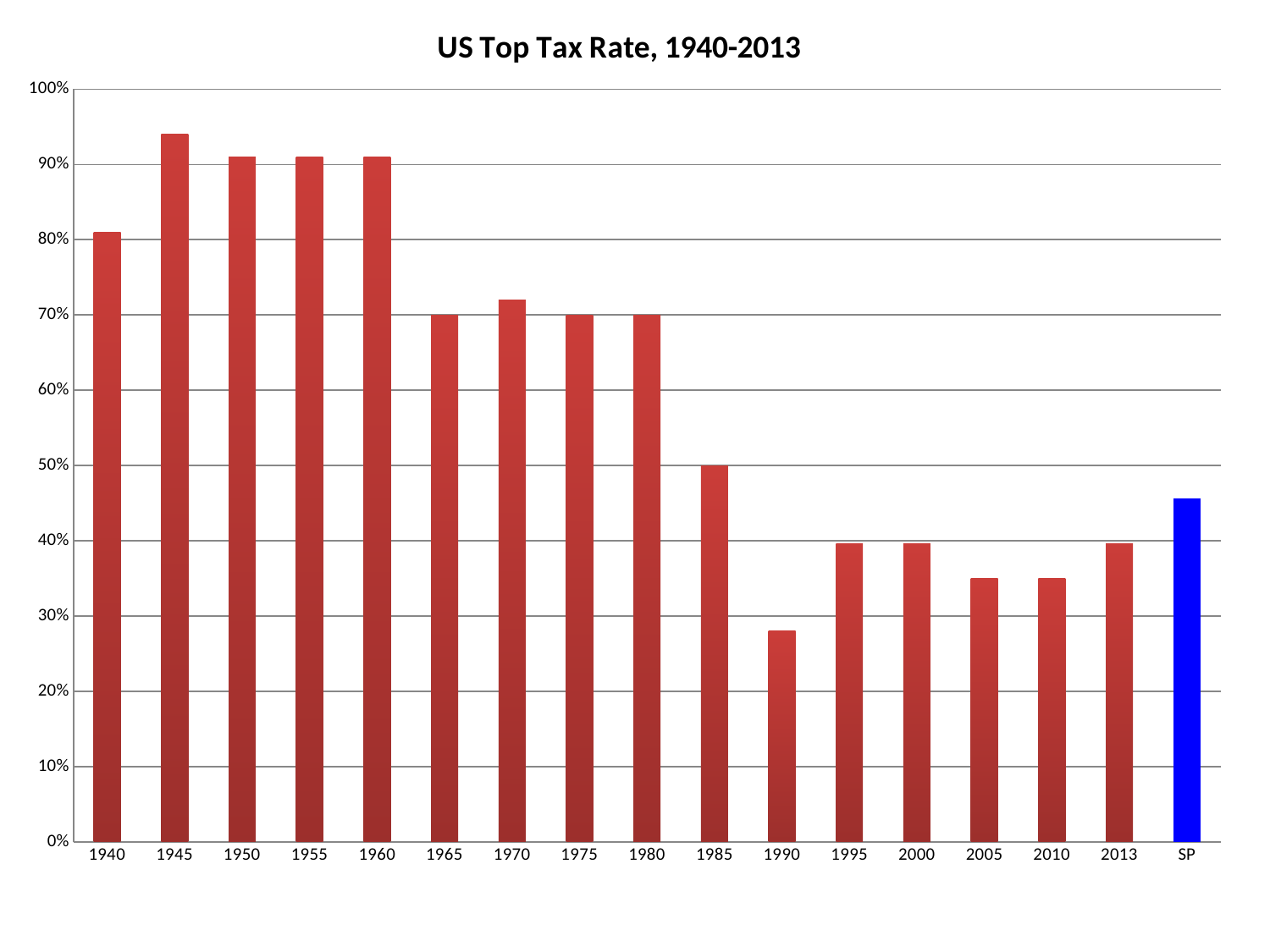
Which category has the highest top tax rate? 1945 Is the value for SP greater or less than 40%? greater Which is larger, the value for 1985 or the value for 1990? 1985 Is the value for 1945 greater or less than 90%? greater Which category has the lowest top tax rate? 1990 What is the top tax rate shown for 1965? 70% What kind of chart is shown on the slide? bar chart Which bar is coloured blue rather than red? SP Is the value for 1990 greater or less than 30%? less How many bars (categories) are plotted on the chart? 17 What is the top tax rate shown for 1985? 50% What is the title of the chart? US Top Tax Rate, 1940-2013